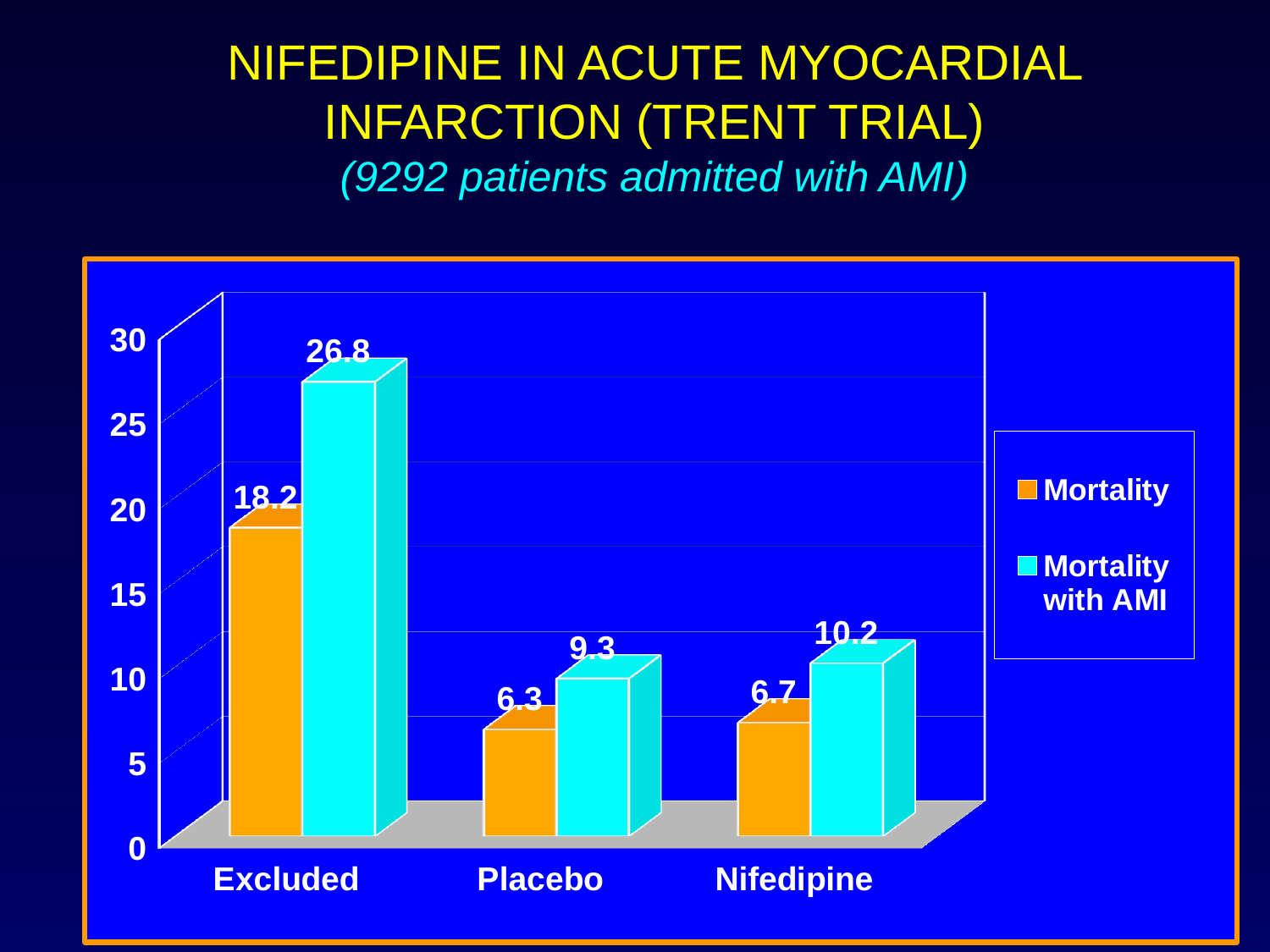
What is the difference between the Mortality with AMI and Mortality values for the Excluded group? 8.6 Which group has the highest Mortality with AMI value? Excluded Is the Mortality with AMI value for the Excluded group greater or less than 25? greater Which is larger: the Mortality with AMI value for Nifedipine or for Placebo? Nifedipine Which group has the lowest Mortality value? Placebo What is the Mortality with AMI value for the Placebo group? 9.3 What is the Mortality value for the Nifedipine group? 6.7 How many groups are shown on the x axis? 3 What kind of chart is shown on the slide? Bar chart What is the difference in Mortality with AMI between the Nifedipine and Placebo groups? 0.9 How many series does the legend list? 2 What is the Mortality value for the Excluded group? 18.2